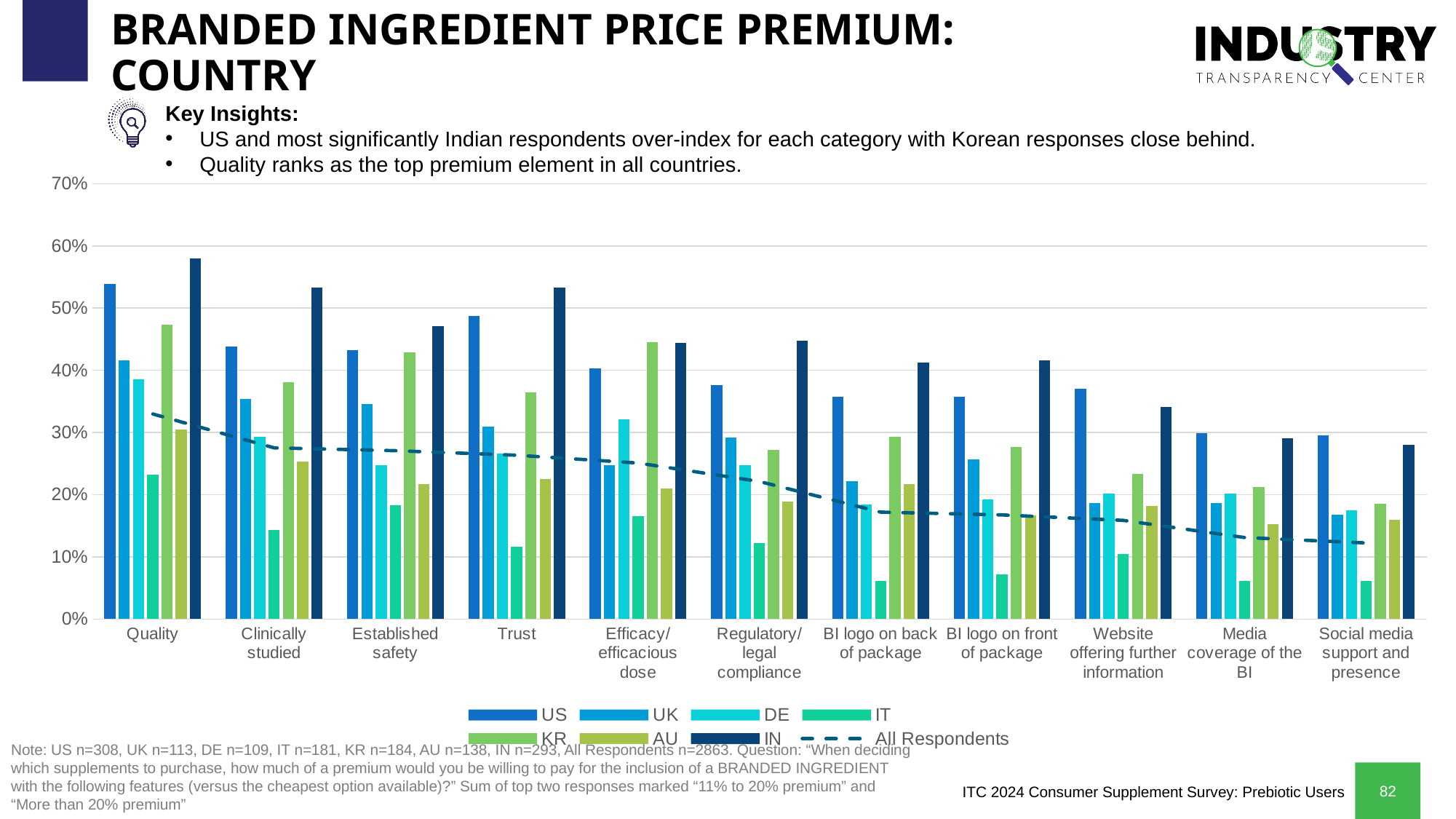
Which country has the lowest value for Clinically studied? IT How many series does the chart legend list? 8 Is the IN value for Trust greater or less than 50%? greater For Trust, which is larger, the US value or the UK value? US Which country has the lowest value for Quality? IT What kind of chart is shown on the slide? combination bar and line chart Is the US value for Quality greater or less than 50%? greater Which country has the highest value for Quality? IN Is the IT value for BI logo on back of package greater or less than 10%? less How many categories are shown along the x axis of the chart? 11 Does the All Respondents dashed line rise or fall from left to right across the categories? fall Which series is drawn as a dashed line rather than bars? All Respondents